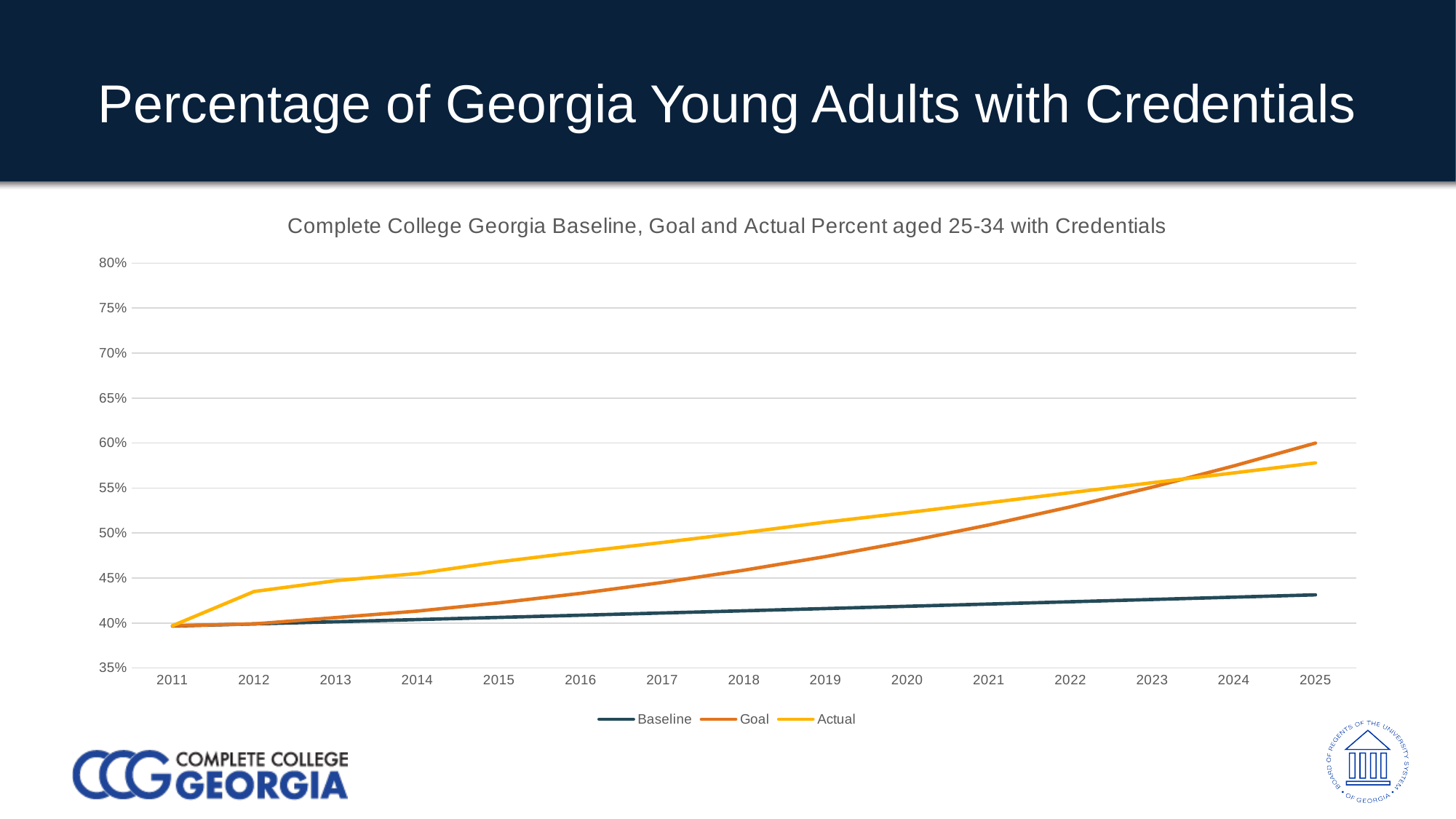
How many series does the legend list? 3 Is the Actual value for 2020 greater or less than 50%? greater In 2020, which is larger, the Actual value or the Goal value? Actual What kind of chart is shown on the slide? line chart Which series has the lowest value in 2025? Baseline Is the Baseline value for 2025 greater or less than 45%? less How many years are shown along the x axis? 15 What is the title printed above the chart? Complete College Georgia Baseline, Goal and Actual Percent aged 25-34 with Credentials In 2025, which is larger, the Actual value or the Goal value? Goal Does the Baseline series rise or fall from 2011 to 2025? rise Which series has the highest value in 2025? Goal